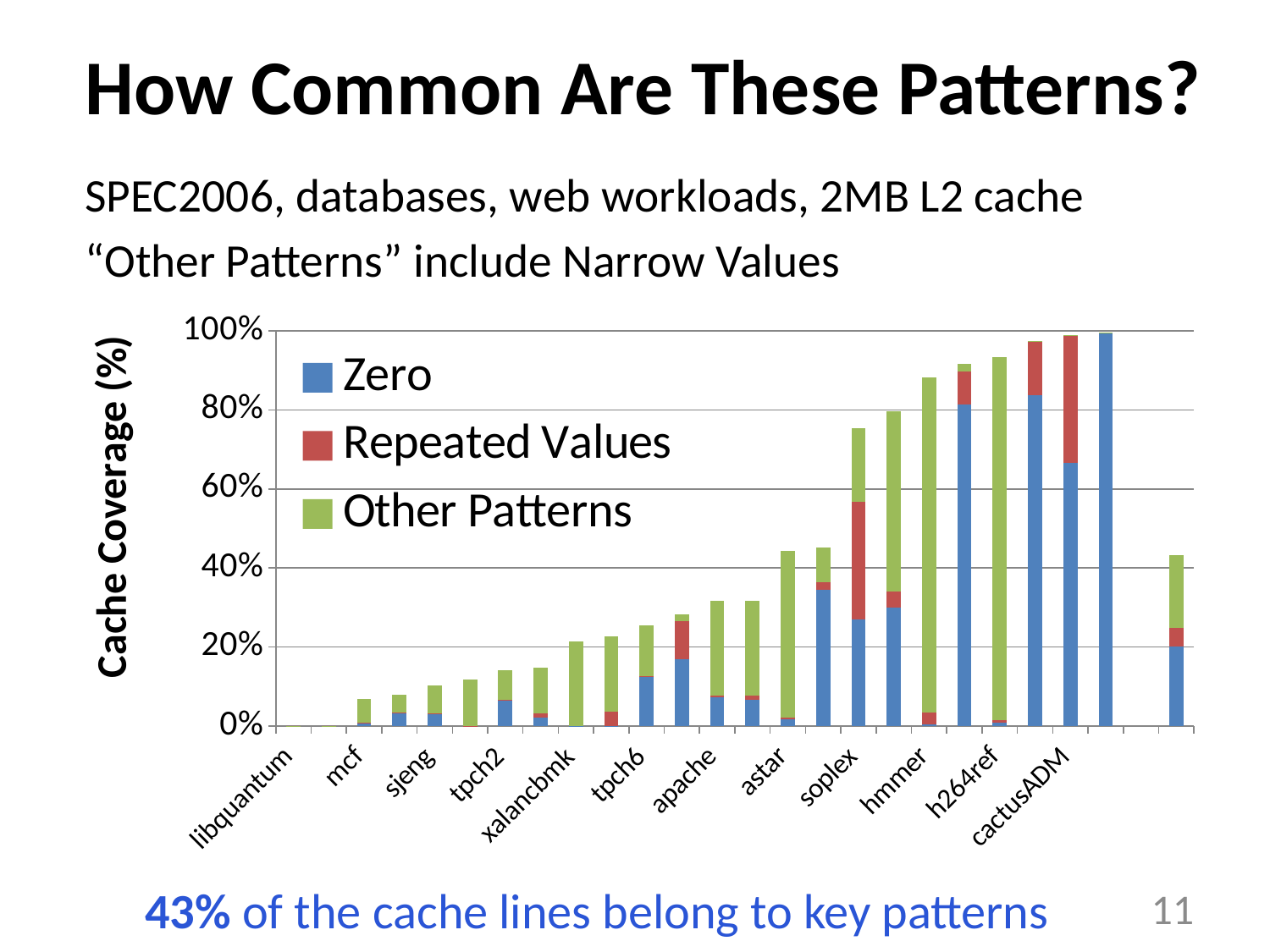
Is the total cache coverage for hmmer greater or less than 60%? greater Is the total cache coverage for libquantum greater or less than 20%? less How many series does the chart's legend list? 3 Is the total cache coverage for mcf greater or less than 20%? less What is the title of the chart's vertical axis? Cache Coverage (%) What kind of chart is shown on the slide? Stacked bar chart Do the total bar heights generally rise or fall moving from left to right across the benchmarks? Rise Which has a larger total cache coverage, cactusADM or libquantum? cactusADM What are the three series named in the chart's legend? Zero, Repeated Values, Other Patterns Which has a larger total cache coverage, h264ref or sjeng? h264ref